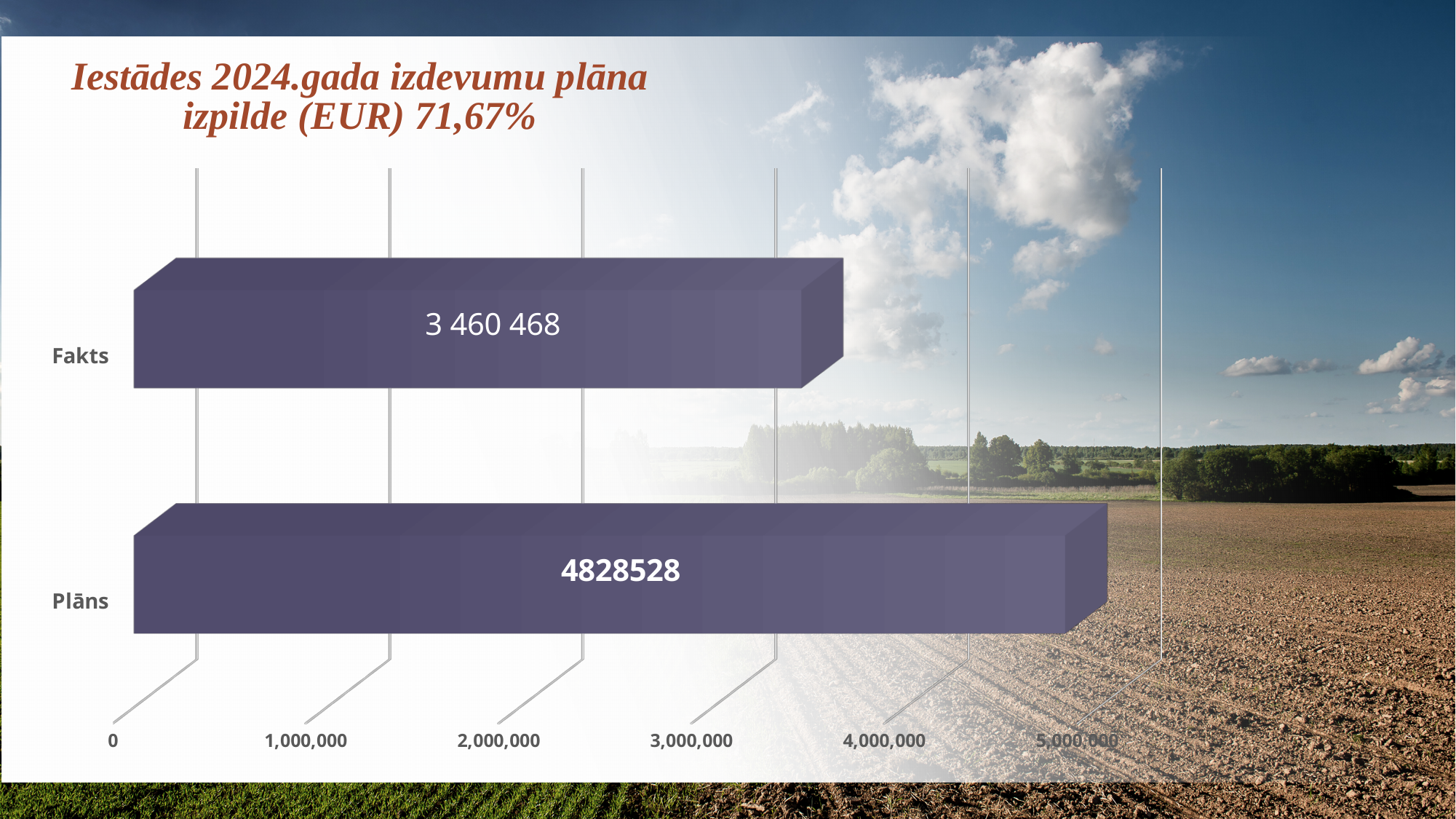
What is the title of the chart? Iestādes 2024.gada izdevumu plāna izpilde (EUR) 71,67% Is the value for Fakts greater or less than 3,000,000? greater How many categories are shown in the chart? 2 What is the value for Plāns? 4828528 Which category has the highest value? Plāns What is the difference between the Plāns value and the Fakts value? 1 368 060 What is the highest tick value shown on the horizontal axis? 5,000,000 What is the value for Fakts? 3 460 468 Is the value for Plāns greater or less than 5,000,000? less Which is larger, the value for Fakts or the value for Plāns? Plāns What kind of chart is shown on the slide? bar chart Which category has the lowest value? Fakts